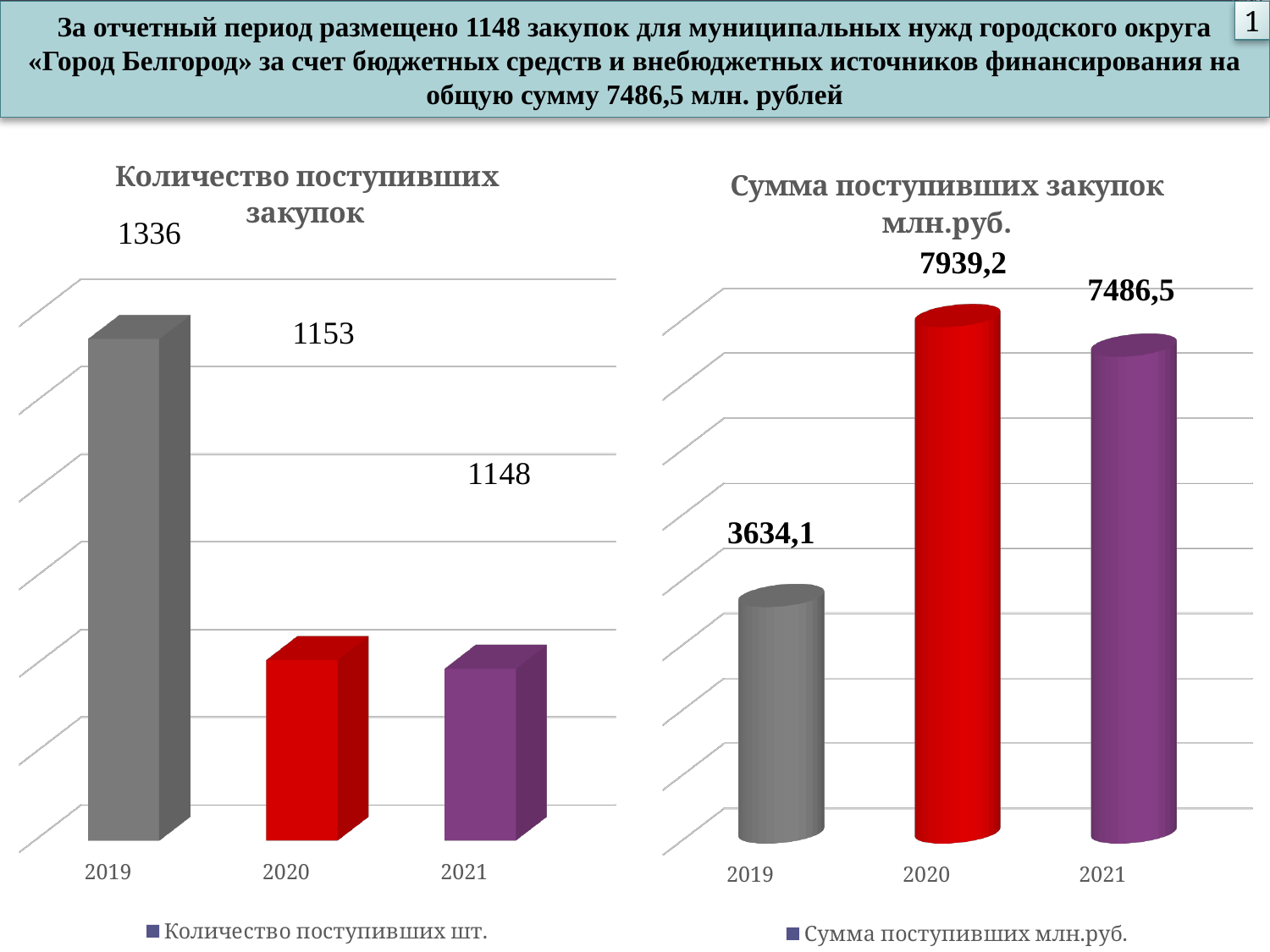
How many years are shown on the x axis of the chart titled "Сумма поступивших закупок млн.руб."? 3 In the chart titled "Сумма поступивших закупок млн.руб.", which year has the lowest value? 2019 In the chart titled "Сумма поступивших закупок млн.руб.", what is the value for 2020? 7939,2 What is the legend entry of the chart titled "Сумма поступивших закупок млн.руб."? Сумма поступивших млн.руб. In the chart titled "Количество поступивших закупок", which year has the highest value? 2019 In the chart titled "Количество поступивших закупок", what is the difference between the values for 2019 and 2020? 183 In the chart titled "Сумма поступивших закупок млн.руб.", what is the value for 2019? 3634,1 What type of chart is the chart titled "Количество поступивших закупок"? Bar chart In the chart titled "Сумма поступивших закупок млн.руб.", which is larger, the value for 2020 or the value for 2021? 2020 In the chart titled "Количество поступивших закупок", what is the value for 2021? 1148 In the chart titled "Сумма поступивших закупок млн.руб.", what is the difference between the values for 2020 and 2021? 452,7 In the chart titled "Количество поступивших закупок", what is the value for 2019? 1336